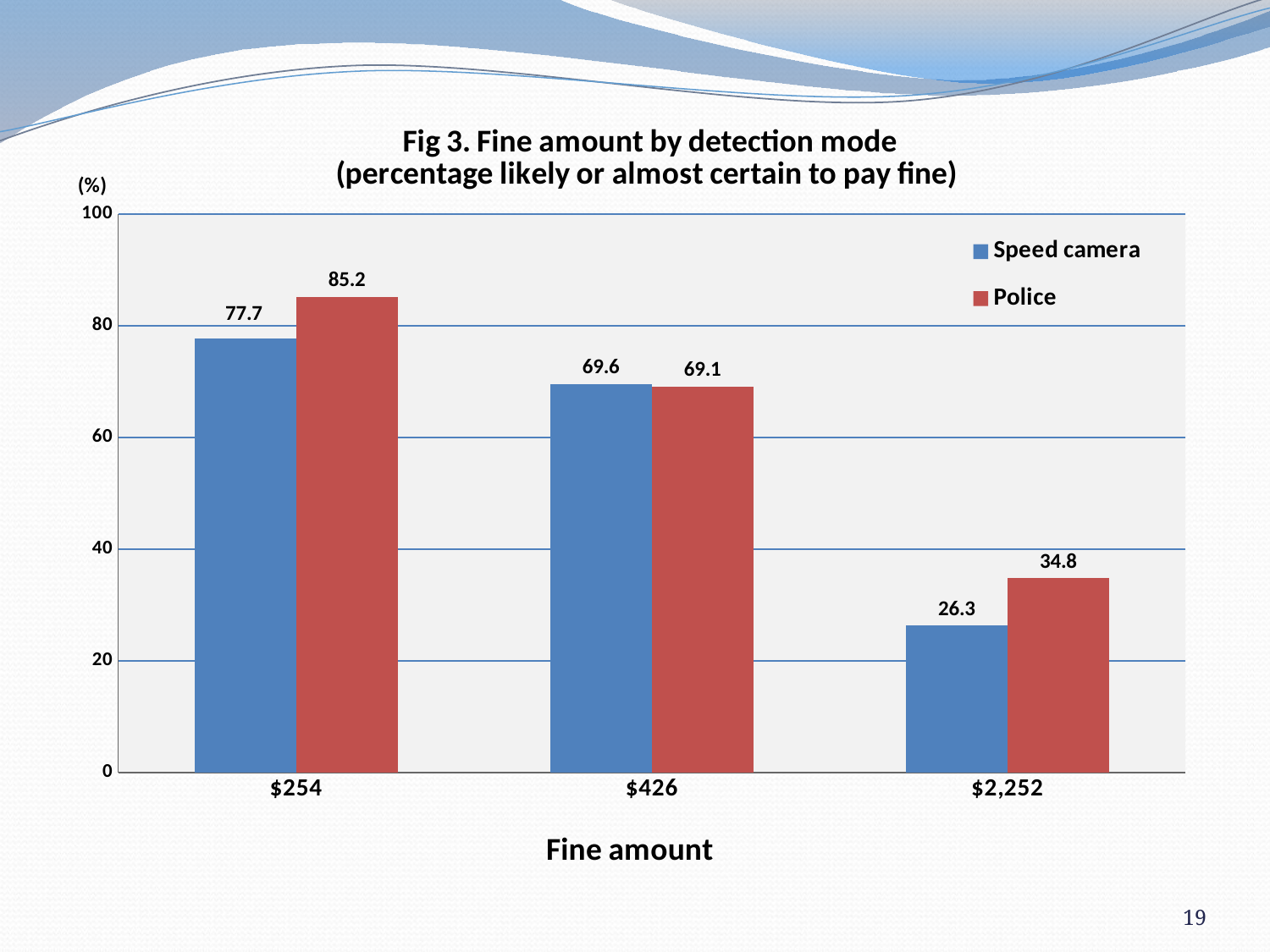
What is the value for Police at the $426 fine amount? 69.1 How many series does the legend list? 2 What is the value for Speed camera at the $254 fine amount? 77.7 Which fine amount has the lowest Speed camera value? $2,252 What kind of chart is shown on the slide? Bar chart Which fine amount has the highest Police value? $254 Do the Speed camera values rise or fall as the fine amount increases along the x axis? Fall How many fine amount categories are shown on the x axis? 3 What is the value for Police at the $2,252 fine amount? 34.8 What is the difference between the Police and Speed camera values at the $254 fine amount? 7.5 At the $254 fine amount, which is larger: Speed camera or Police? Police What is the difference between the Police and Speed camera values at the $2,252 fine amount? 8.5